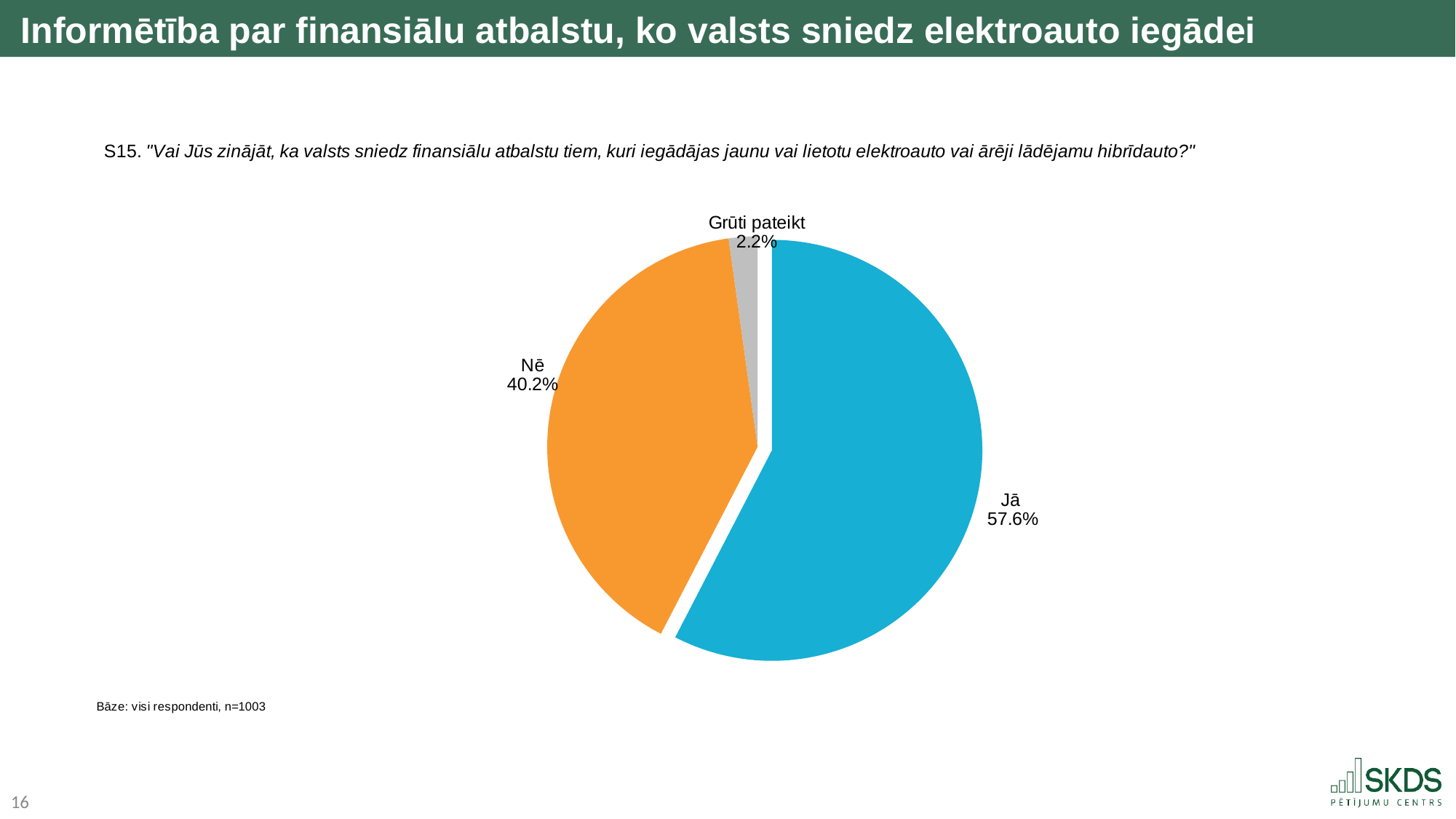
What kind of chart is shown on the slide? pie chart How many slices does the pie chart have? 3 What share of respondents answered "Grūti pateikt"? 2.2% What is the base (n) stated below the chart? n=1003 What share of respondents answered "Nē"? 40.2% What colour is the "Jā" slice? blue Which is larger, the share for "Nē" or the share for "Grūti pateikt"? Nē Which answer has the smallest slice of the pie? Grūti pateikt What is the difference in percentage points between "Jā" and "Nē"? 17.4 Which answer has the largest slice of the pie? Jā What share of respondents answered "Jā"? 57.6%